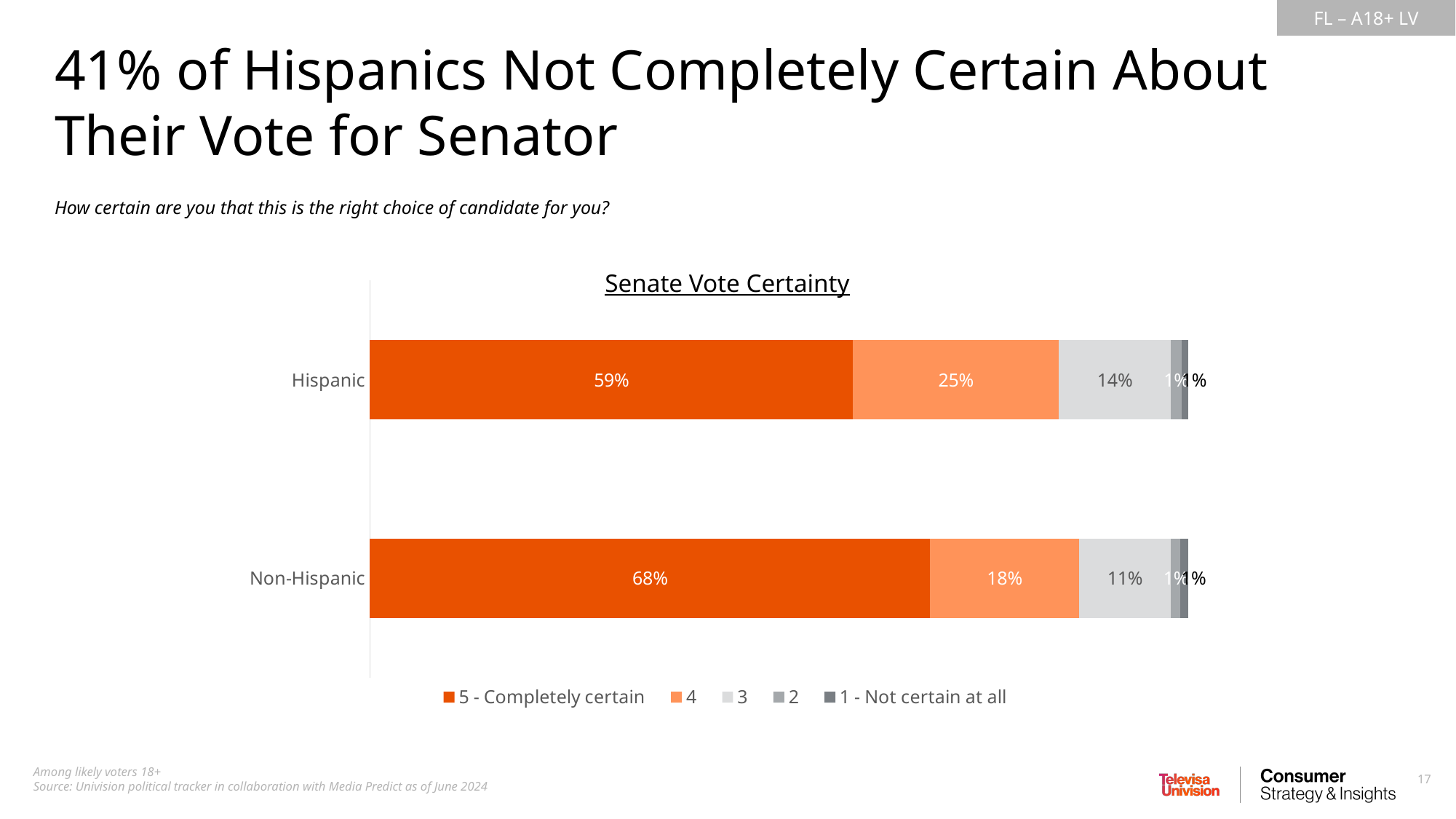
What percentage of Hispanic likely voters are '5 - Completely certain' about their Senate vote? 59% How many series does the legend list? 5 What is the difference in the '5 - Completely certain' share between Non-Hispanic and Hispanic voters? 9 percentage points Which rating category has the largest share for Hispanic voters? 5 - Completely certain What is the value for the '4' rating among Non-Hispanic voters? 18% How many groups (categories) are shown on the chart? 2 What type of chart is shown on the slide? Stacked bar chart What is the value for the '4' rating among Hispanic voters? 25% What percentage of Non-Hispanic likely voters are '5 - Completely certain' about their Senate vote? 68% What is the difference in the '3' rating between Hispanic and Non-Hispanic voters? 3 percentage points Which group has the higher share of '5 - Completely certain' responses, Hispanic or Non-Hispanic? Non-Hispanic What is the value for the '3' rating among Non-Hispanic voters? 11%